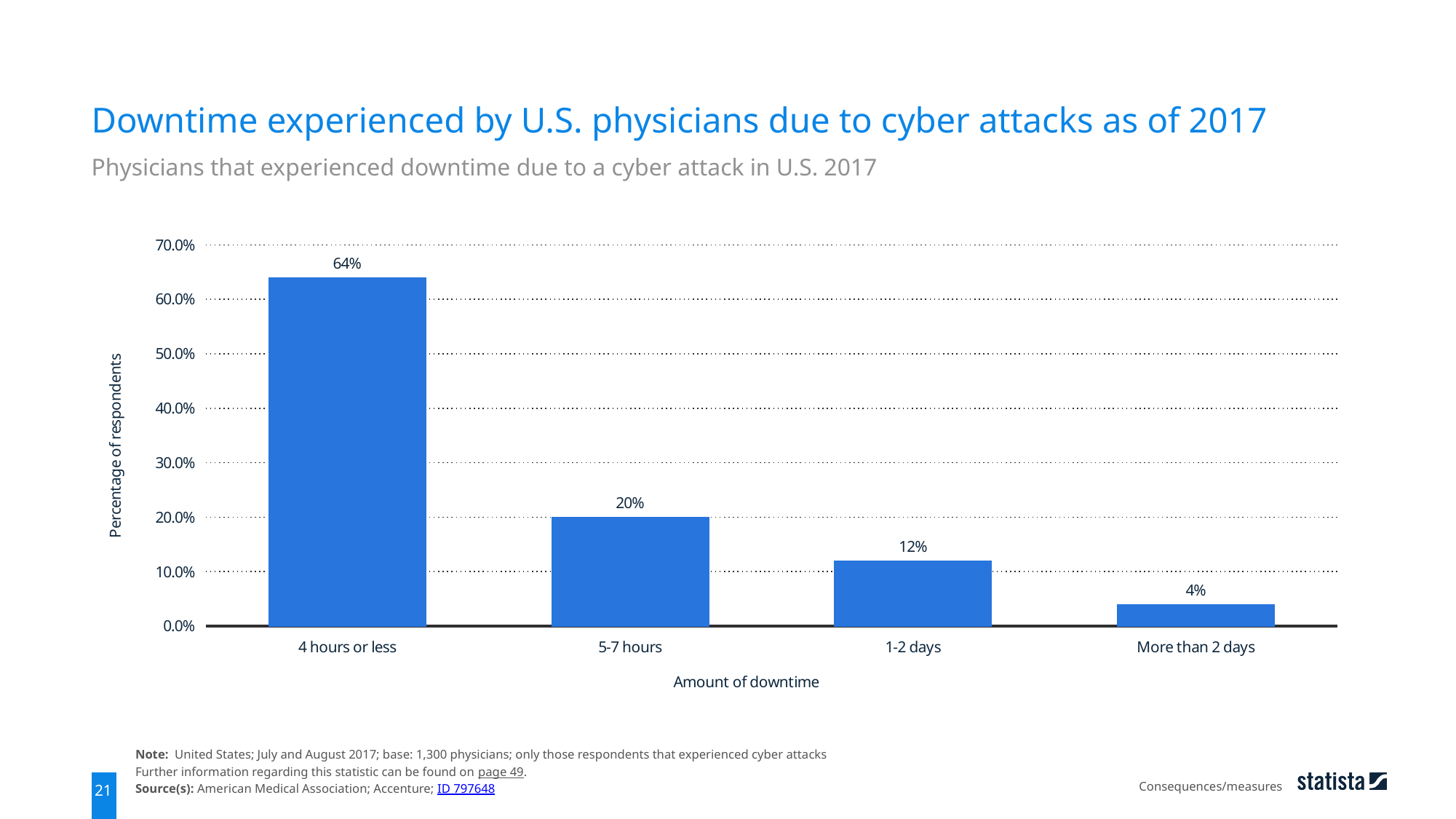
What kind of chart is shown on the slide? Bar chart What percentage of respondents experienced downtime of 4 hours or less? 64% How many downtime categories are shown on the chart? 4 What is the value for the More than 2 days category? 4% What is the difference between the values for 4 hours or less and 5-7 hours? 44% Which is larger, the value for 5-7 hours or the value for 1-2 days? 5-7 hours Which amount of downtime has the highest percentage of respondents? 4 hours or less What percentage of respondents experienced downtime of 1-2 days? 12% What is the difference between the values for 1-2 days and More than 2 days? 8% What is the value for the 5-7 hours category? 20% Which amount of downtime has the lowest percentage of respondents? More than 2 days What is the label of the x axis? Amount of downtime